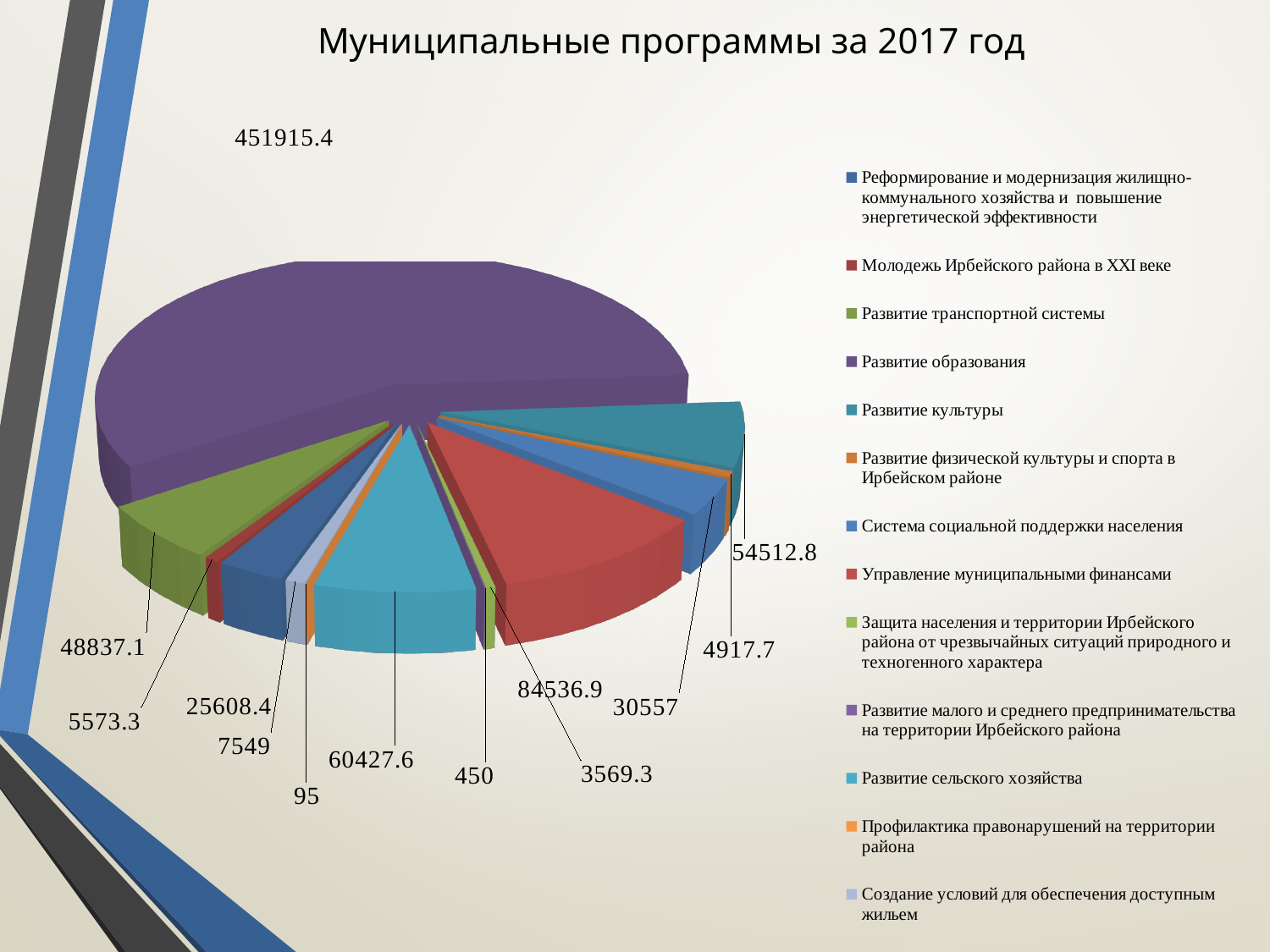
Which program has the largest slice of the pie? Развитие образования What is the value for Управление муниципальными финансами? 84536.9 What is the value for Развитие культуры? 54512.8 How many categories does the legend list? 13 What kind of chart is shown on the slide? pie chart Which program has the smallest slice of the pie? Профилактика правонарушений на территории района What is the value for Развитие транспортной системы? 48837.1 What is the difference between Управление муниципальными финансами and Развитие сельского хозяйства? 24109.3 What is the value for Развитие образования? 451915.4 Which is larger: Управление муниципальными финансами or Развитие сельского хозяйства? Управление муниципальными финансами What is the value for Развитие сельского хозяйства? 60427.6 What is the title of the chart? Муниципальные программы за 2017 год